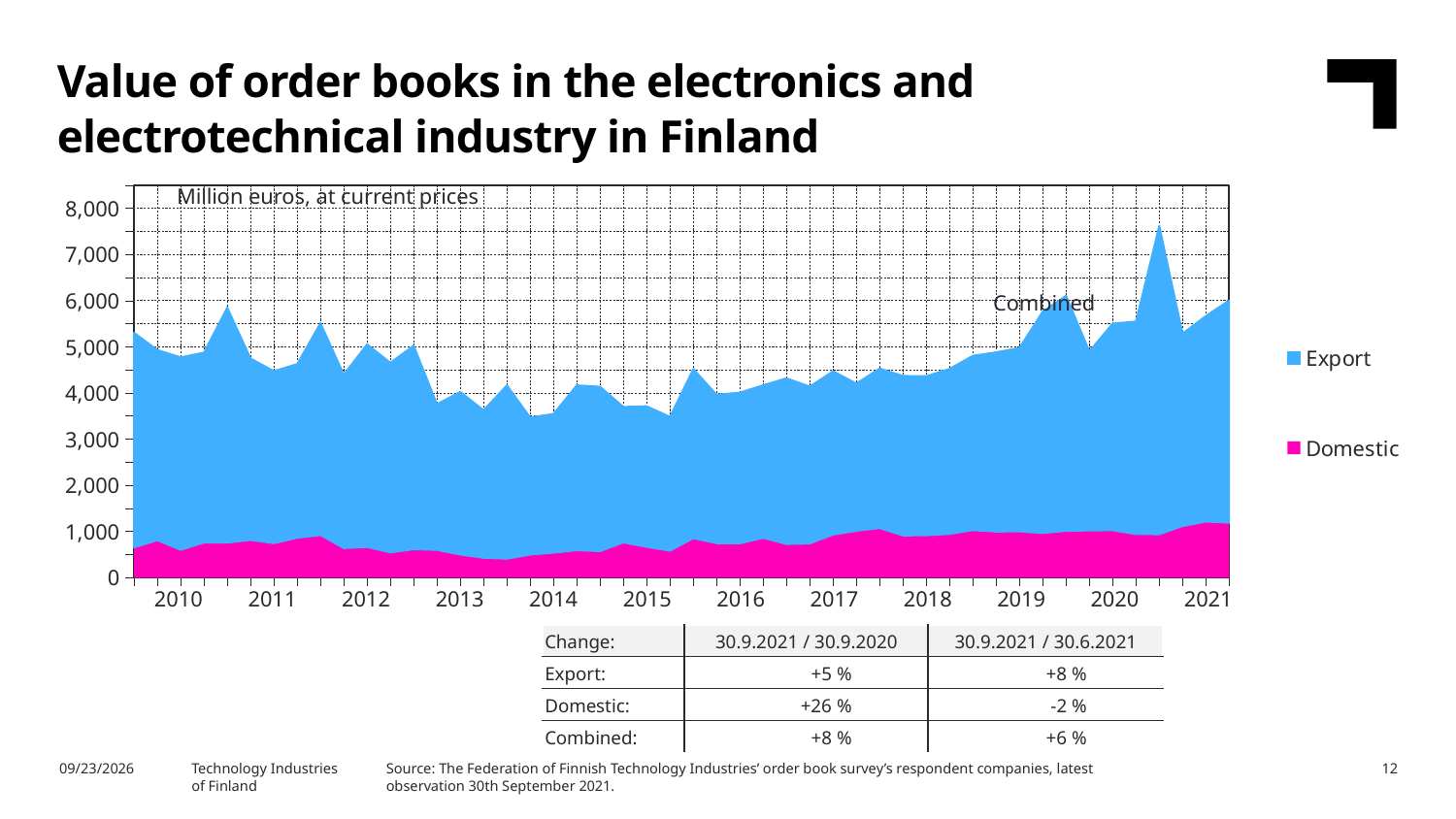
How many years are labelled on the x axis? 12 Which series has the larger values throughout the chart, Export or Domestic? Export Is the highest combined peak in 2020 greater or less than 7,000? greater How many series does the legend list? 2 Is the Domestic value in 2021 greater or less than 2,000? less Does the combined value rise or fall overall from 2018 to 2021? rise What unit is stated at the top of the chart? Million euros, at current prices Is the combined value at the start of 2010 greater or less than 6,000? less What kind of chart is shown on the slide? Area chart What is the highest value shown on the y axis? 8,000 What are the two series named in the legend? Export and Domestic In which year does the combined value reach its highest peak? 2020